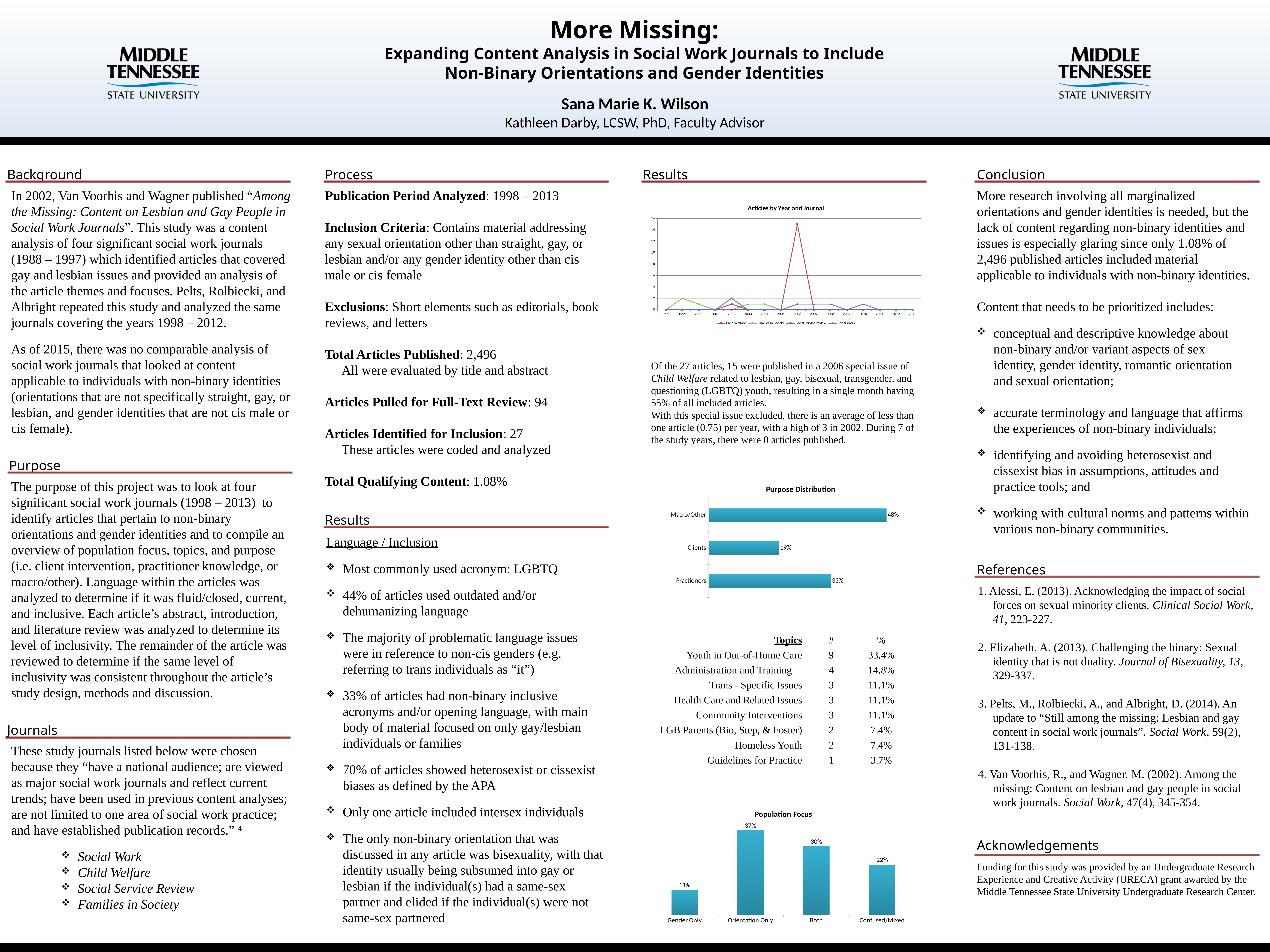
In the Purpose Distribution chart, which category has the lowest value? Clients In the Population Focus chart, which is larger, Both or Gender Only? Both In the Purpose Distribution chart, what is the value for Macro/Other? 48% In the Articles by Year and Journal chart, is the value for Child Welfare in 2006 greater or less than 10? greater In the Population Focus chart, what is the value for Confused/Mixed? 22% In the Purpose Distribution chart, what is the difference between Macro/Other and Clients? 29 percentage points In the Population Focus chart, which category has the highest value? Orientation Only In the Purpose Distribution chart, how many categories are shown? 3 What kind of chart is the Population Focus chart? Bar chart In the Articles by Year and Journal chart, how many series does the legend list? 4 What kind of chart is the Articles by Year and Journal chart? Line chart In the Population Focus chart, what is the difference between Orientation Only and Both? 7 percentage points